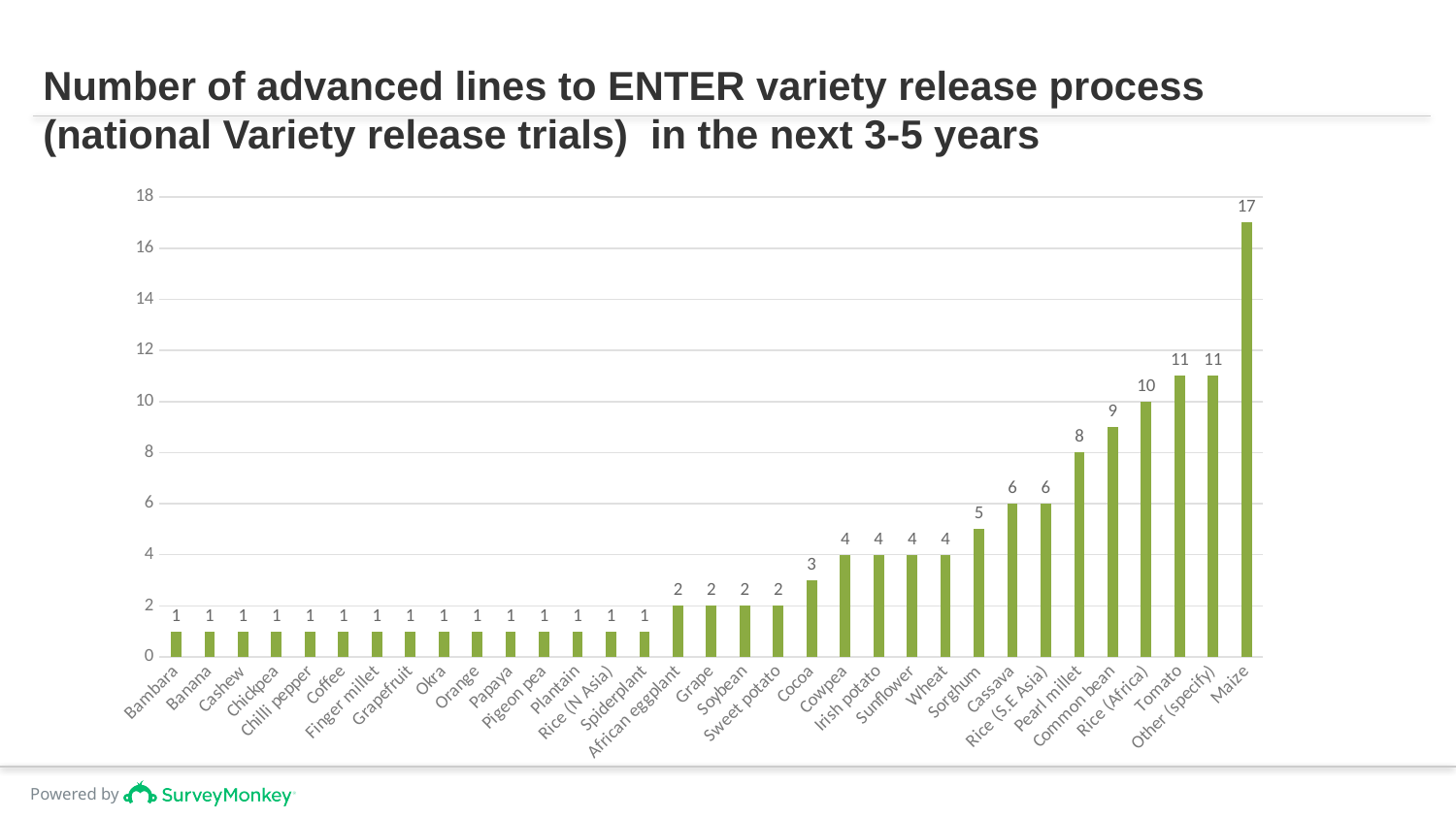
What is the value for Maize? 17 What is the value for Rice (Africa)? 10 Is the value for Maize greater or less than 16? greater What is the difference between the values for Maize and Tomato? 6 What kind of chart is shown on the slide? bar chart What is the value for Cocoa? 3 What is the difference between the values for Common bean and Sorghum? 4 Which is larger, the value for Cassava or the value for Cowpea? Cassava What is the value for Pearl millet? 8 Do the values rise or fall from left to right along the x axis? rise Which category has the highest value? Maize How many categories are shown on the x axis? 33